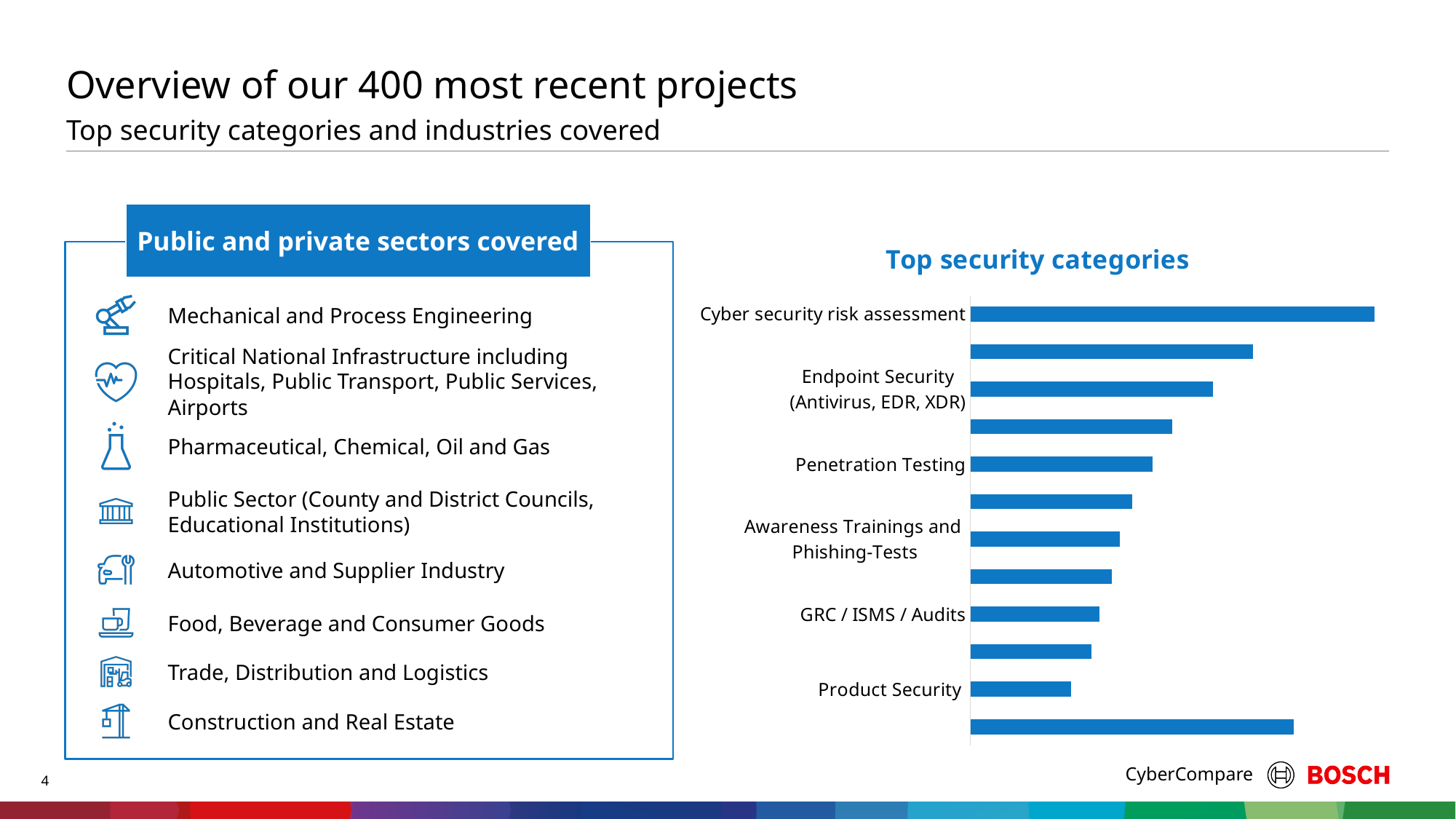
In the "Top security categories" chart, which bar is longer: Endpoint Security (Antivirus, EDR, XDR) or GRC / ISMS / Audits? Endpoint Security (Antivirus, EDR, XDR) In the "Top security categories" chart, do the bars get shorter or longer going from Cyber security risk assessment down to Product Security? shorter In the "Top security categories" chart, which labelled category has the longest bar? Cyber security risk assessment How many bars are plotted in the "Top security categories" chart? 12 How many category labels are printed on the axis of the "Top security categories" chart? 6 In the "Top security categories" chart, which bar is longer: Awareness Trainings and Phishing-Tests or Product Security? Awareness Trainings and Phishing-Tests What is the title of the chart on the right side of the slide? Top security categories In the "Top security categories" chart, which labelled category has the shortest bar? Product Security What colour are the bars in the "Top security categories" chart? blue In the "Top security categories" chart, which bar is longer: Cyber security risk assessment or Penetration Testing? Cyber security risk assessment What kind of chart is shown under the title "Top security categories"? bar chart